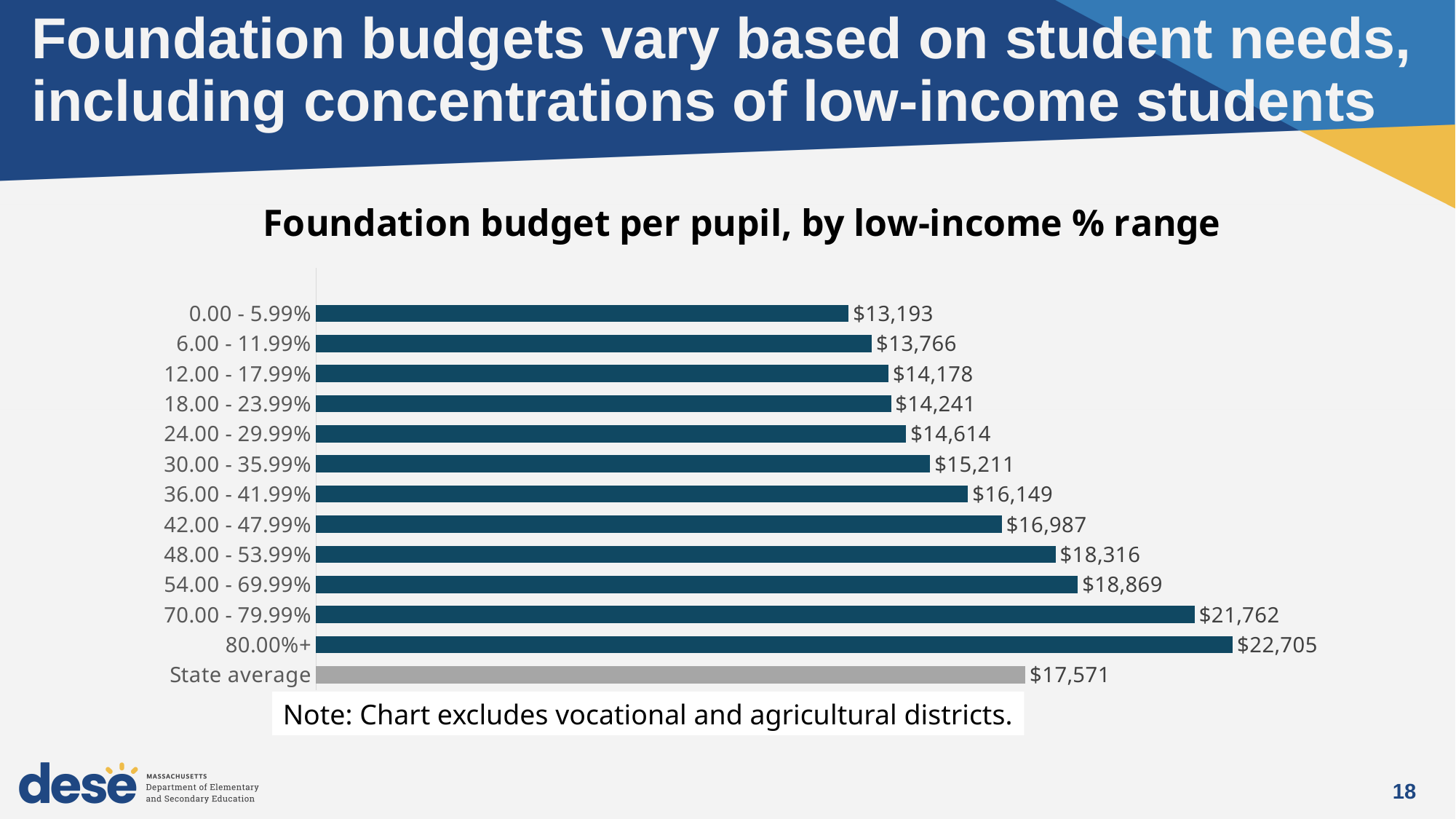
What is the difference between the foundation budget per pupil for the 70.00 - 79.99% range and the state average? $4,191 What type of chart is shown on the slide? Bar chart Which is larger: the foundation budget per pupil for the 48.00 - 53.99% range or the state average? The 48.00 - 53.99% range ($18,316 vs $17,571) What is the state average foundation budget per pupil shown on the chart? $17,571 Which low-income % range has the lowest foundation budget per pupil? 0.00 - 5.99% What is the foundation budget per pupil for the 80.00%+ low-income range? $22,705 What is the title of the chart? Foundation budget per pupil, by low-income % range What is the foundation budget per pupil for the 0.00 - 5.99% low-income range? $13,193 What is the foundation budget per pupil for the 42.00 - 47.99% range? $16,987 How many bars are shown on the chart, including the state average? 13 What is the difference between the foundation budget per pupil for the 80.00%+ range and the 0.00 - 5.99% range? $9,512 Which low-income % range has the highest foundation budget per pupil? 80.00%+